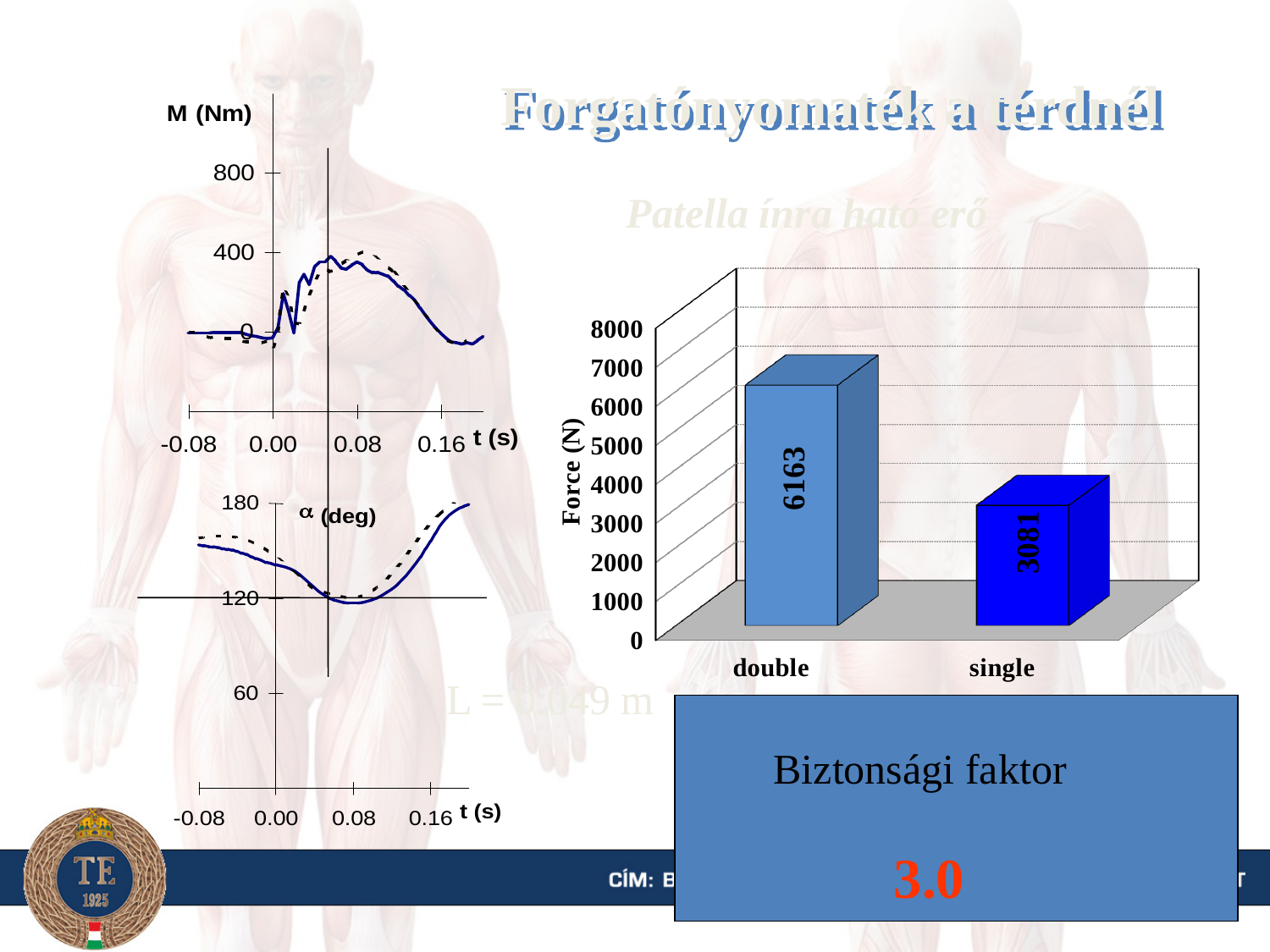
In the bar chart on the right, is the value for "single" greater or less than 4000? less In the bar chart on the right, which category has the highest force? double What is the y-axis label of the bar chart on the right? Force (N) In the bar chart on the right, which category has the lowest force? single What kind of chart is the chart on the right of the slide? bar chart What is the x-axis label of the bottom-left chart with the α (deg) axis? t (s) In the bar chart on the right, what is the value for "single"? 3081 In the bar chart on the right, what is the difference between the values for "double" and "single"? 3082 What kind of chart is the top-left chart with the M (Nm) axis? line chart How many categories are shown in the bar chart on the right? 2 In the bar chart on the right, what is the value for "double"? 6163 In the bar chart on the right, is the value for "double" larger or smaller than the value for "single"? larger